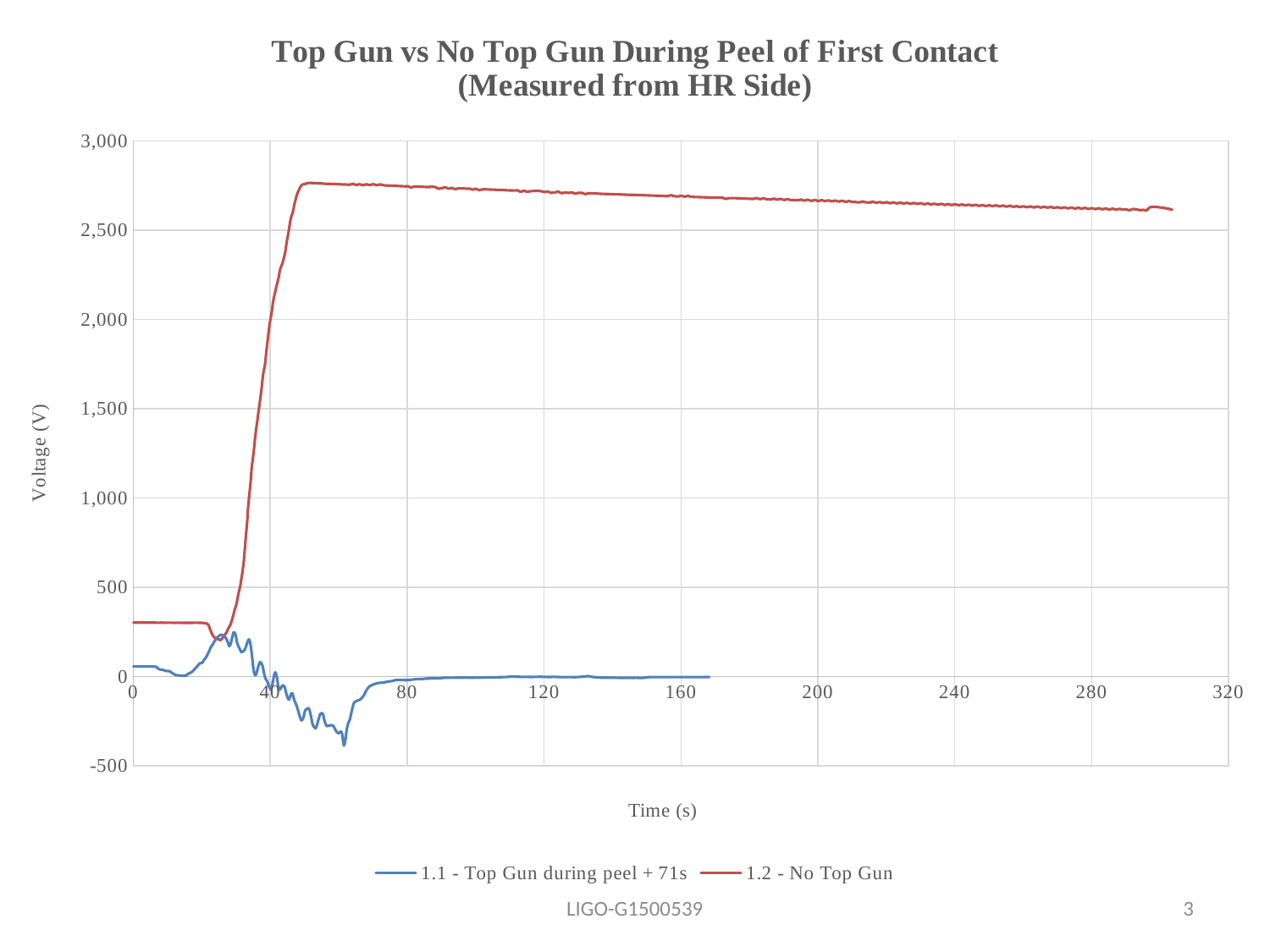
Is the value for 1.2 - No Top Gun at 200 s greater or less than 2,500? greater What kind of chart is shown on the slide? line chart Is the value for 1.2 - No Top Gun at time 0 greater or less than 500? less Which series reaches the higher maximum voltage? 1.2 - No Top Gun Is the peak value of the 1.2 - No Top Gun series greater or less than 3,000? less Does the 1.2 - No Top Gun series rise or fall between 80 s and 300 s? fall What is the label of the vertical axis? Voltage (V) At 160 s, which series has the higher voltage? 1.2 - No Top Gun What are the two series named in the legend? 1.1 - Top Gun during peel + 71s; 1.2 - No Top Gun How many series does the legend list? 2